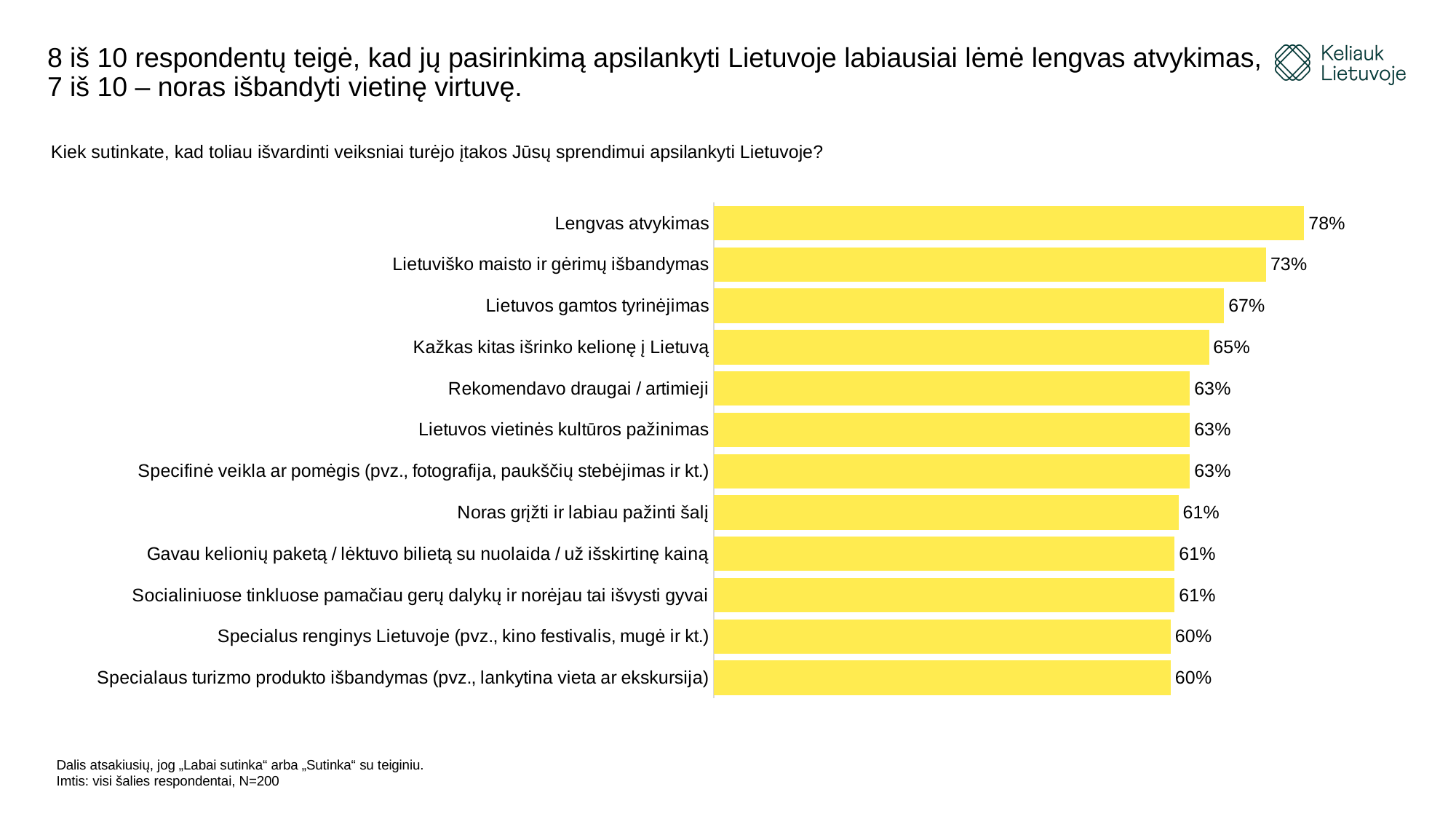
What is the difference between "Lengvas atvykimas" and "Lietuviško maisto ir gėrimų išbandymas"? 5% What kind of chart is shown on the slide? Bar chart What is the value for "Noras grįžti ir labiau pažinti šalį"? 61% What colour are the bars in the chart? Yellow How many categories have a value of 63%? 3 What is the value for "Lengvas atvykimas"? 78% Which is larger: "Lietuviško maisto ir gėrimų išbandymas" or "Rekomendavo draugai / artimieji"? Lietuviško maisto ir gėrimų išbandymas What is the difference between "Lietuvos gamtos tyrinėjimas" and "Kažkas kitas išrinko kelionę į Lietuvą"? 2% What is the value for "Specialus renginys Lietuvoje (pvz., kino festivalis, mugė ir kt.)"? 60% How many categories are shown in the chart? 12 What is the value for "Lietuvos gamtos tyrinėjimas"? 67% Which category has the highest value? Lengvas atvykimas